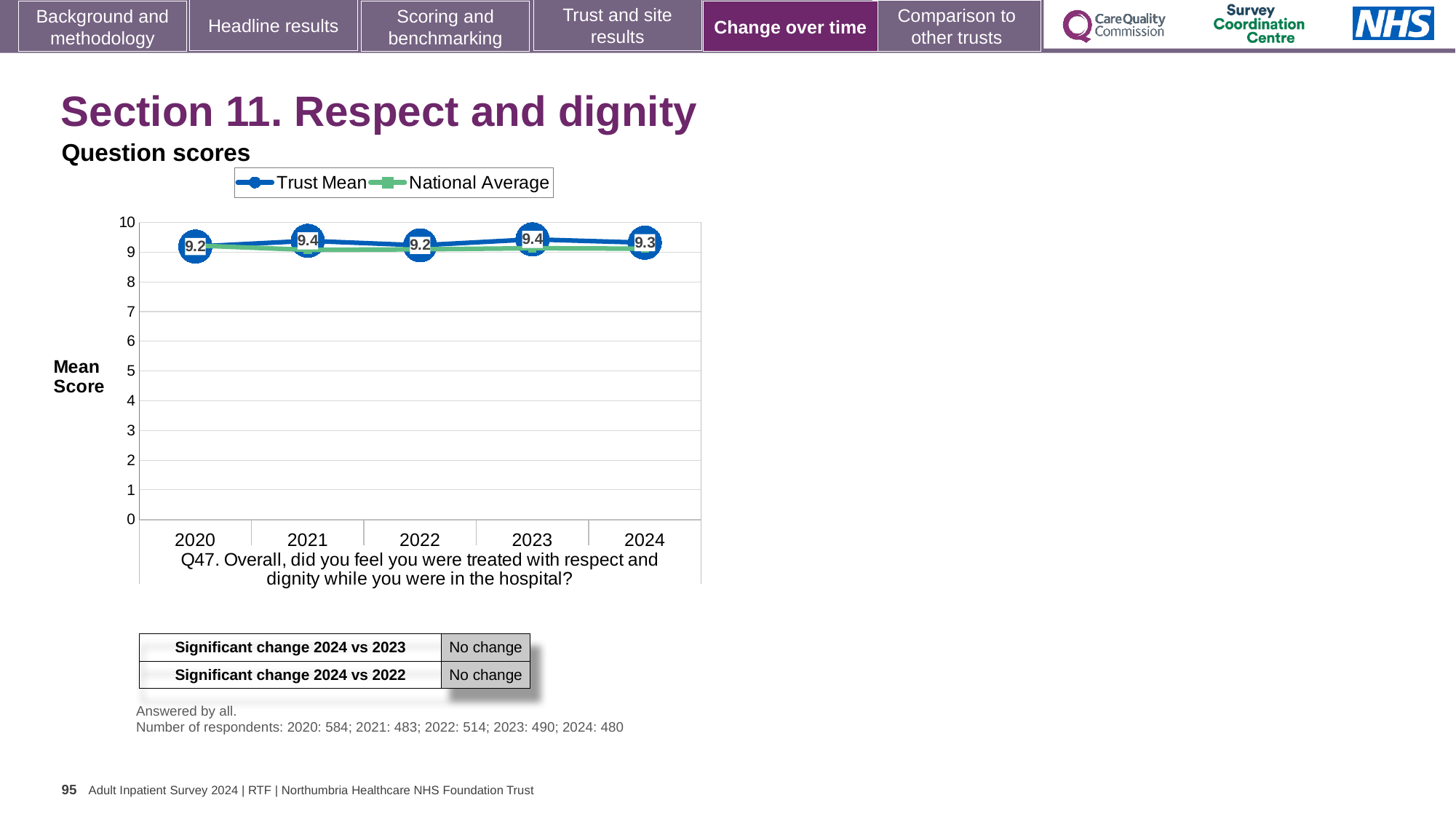
What is the Trust Mean value for 2021? 9.4 Is the National Average value for 2022 greater or less than 5? greater What is the Trust Mean value for 2024? 9.3 What kind of chart is shown on the slide? Line chart What is the label on the y axis of the chart? Mean Score How many series does the chart legend list? 2 Which year has the larger Trust Mean, 2020 or 2021? 2021 What is the difference between the Trust Mean in 2021 and in 2020? 0.2 What is the Trust Mean value for 2023? 9.4 What is the difference between the Trust Mean in 2023 and in 2024? 0.1 What is the Trust Mean value for 2020? 9.2 How many years are shown on the x axis of the chart? 5